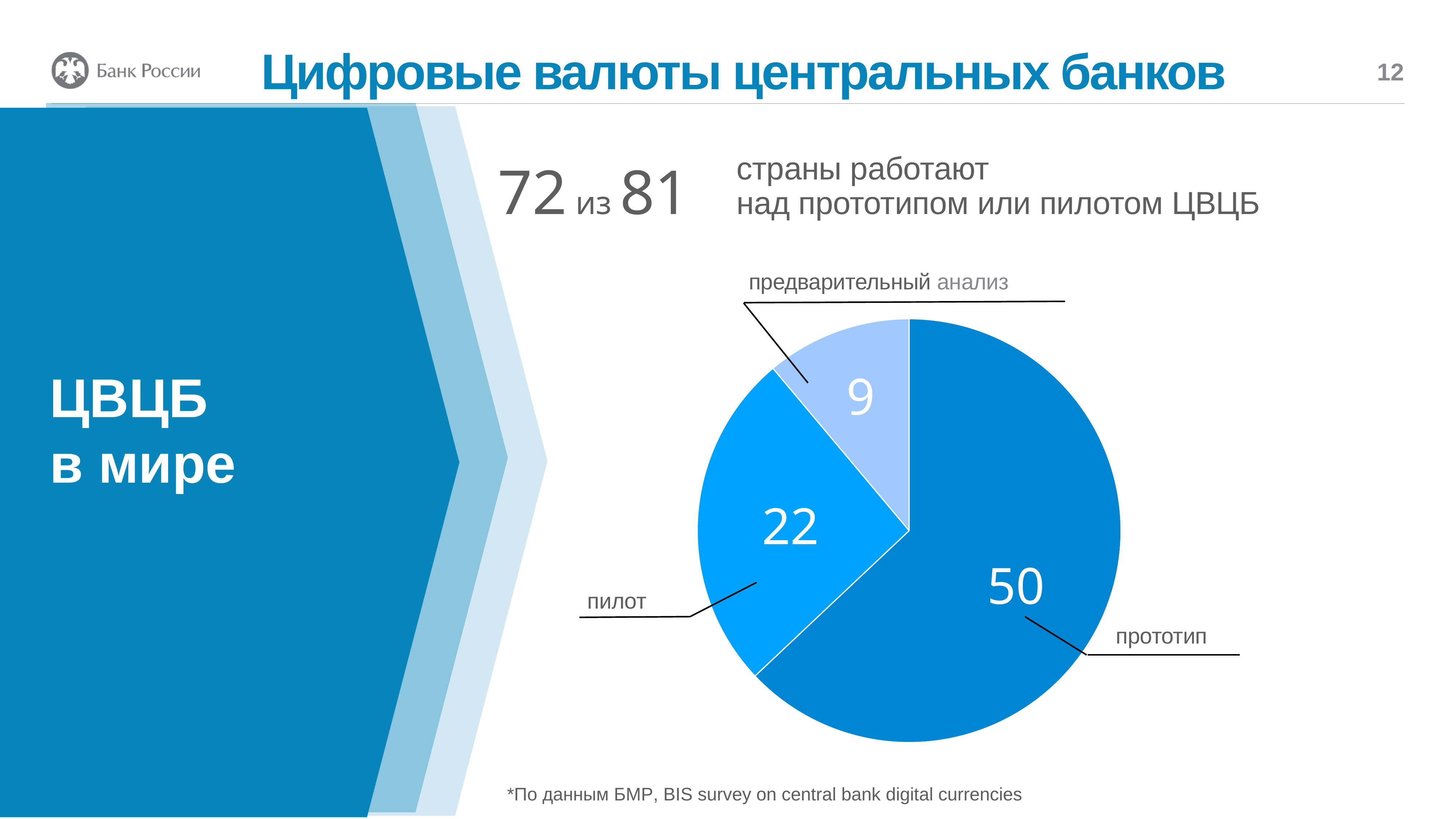
What is the difference between the пилот and предварительный анализ values in the pie chart? 13 What is the total of all slices in the pie chart? 81 What is the value of the предварительный анализ slice in the pie chart? 9 What is the difference between the прототип and пилот values in the pie chart? 28 Which is larger in the pie chart: пилот or предварительный анализ? пилот Which slice of the pie chart is the smallest? предварительный анализ What is the value of the пилот slice in the pie chart? 22 What is the value of the прототип slice in the pie chart? 50 Which slice of the pie chart is the largest? прототип What type of chart is shown on the slide? pie chart What is the title of the slide containing the pie chart? Цифровые валюты центральных банков How many slices does the pie chart have? 3